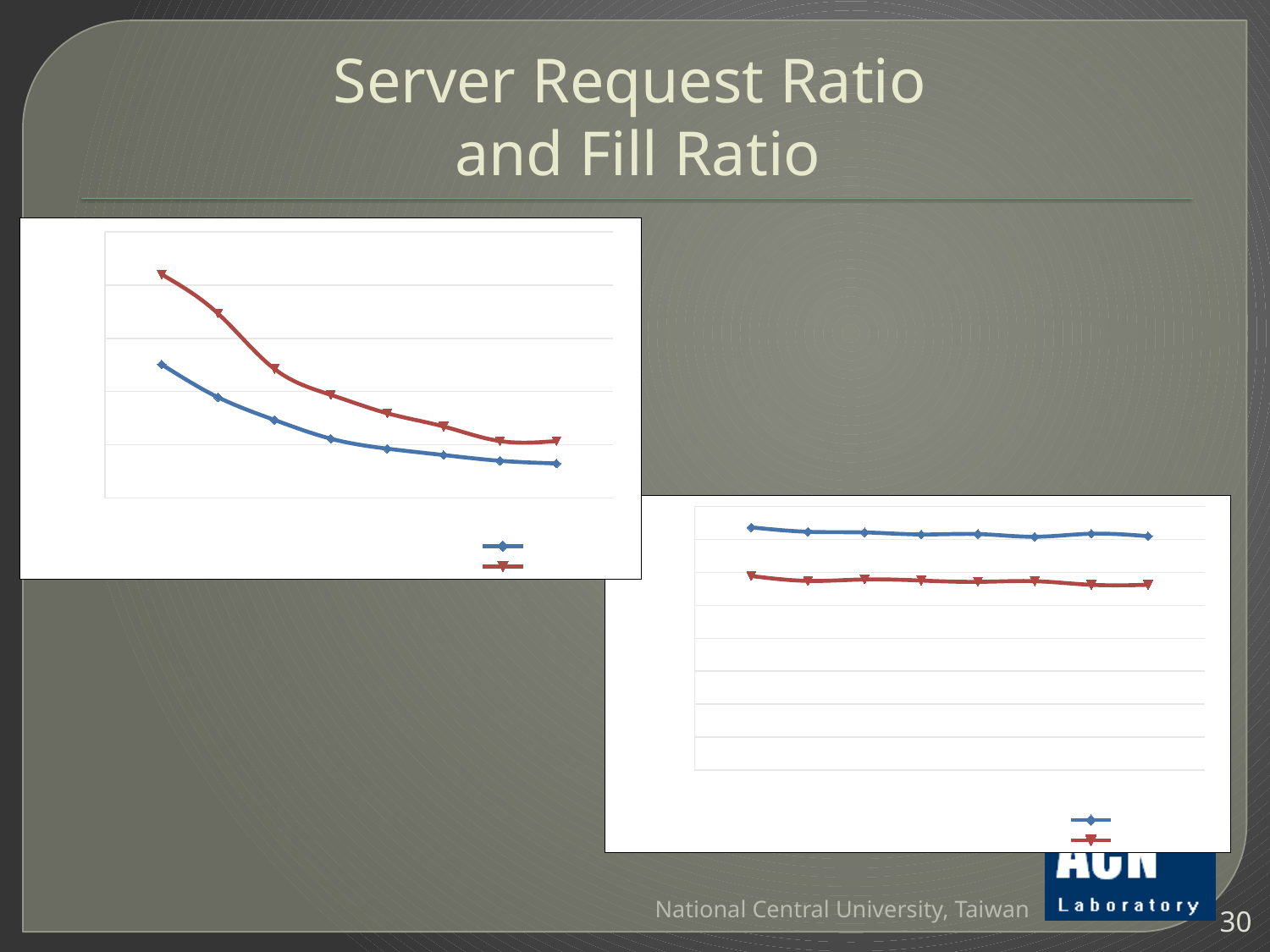
In the bottom-right chart, which series has the higher values, the red one or the blue one? the blue one What kind of chart is the bottom-right chart? line chart How many series does the legend of the bottom-right chart list? 2 In the top-left chart, do the values rise or fall along the x axis? fall In the top-left chart, which series has the higher values, the red one or the blue one? the red one What kind of chart is the top-left chart? line chart How many data points does each series in the bottom-right chart have? 8 In the bottom-right chart, do the values change strongly or stay roughly flat along the x axis? roughly flat What two colours are used for the series lines in the top-left chart? blue and red How many series does the legend of the top-left chart list? 2 What is the title of the slide containing the two charts? Server Request Ratio and Fill Ratio How many data points does each series in the top-left chart have? 8